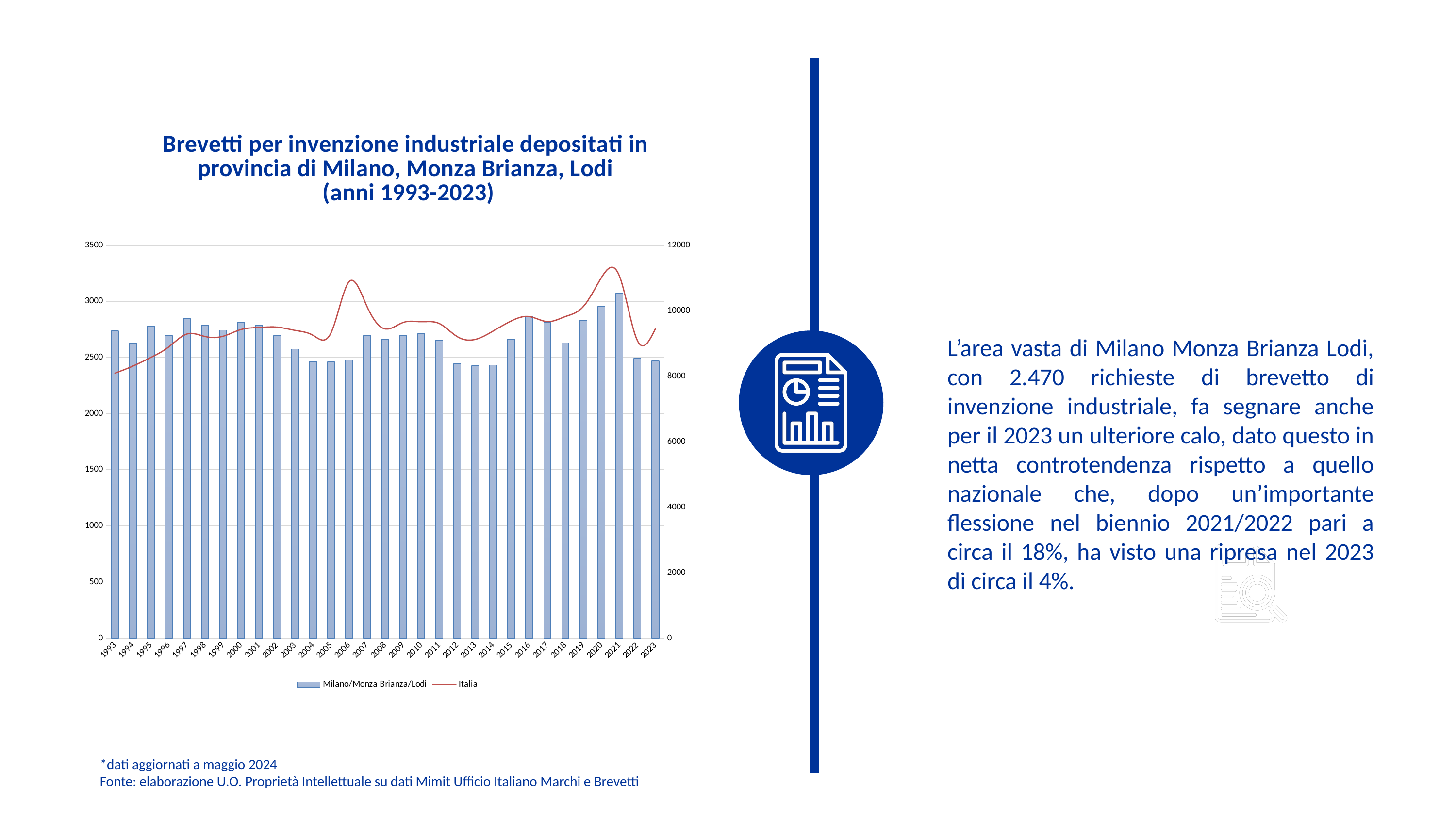
Which bar is taller, 2021 or 2023? 2021 What is the maximum value shown on the right-hand axis of the chart? 12000 How many series does the chart legend list? 2 Is the Italia value for 1993 greater or less than 10000 on the right axis? less In which year does the Italia line reach its highest point? 2021 What are the two entries in the chart legend? Milano/Monza Brianza/Lodi and Italia How many years are shown on the x axis of the chart? 31 Is the Milano/Monza Brianza/Lodi value for 2013 greater or less than 2500? less Is the Milano/Monza Brianza/Lodi value for 2021 greater or less than 3000? greater What kind of chart is shown on the slide? A bar chart combined with a line Do the Milano/Monza Brianza/Lodi bars rise or fall from 2021 to 2023? fall Which year has the highest bar for Milano/Monza Brianza/Lodi? 2021